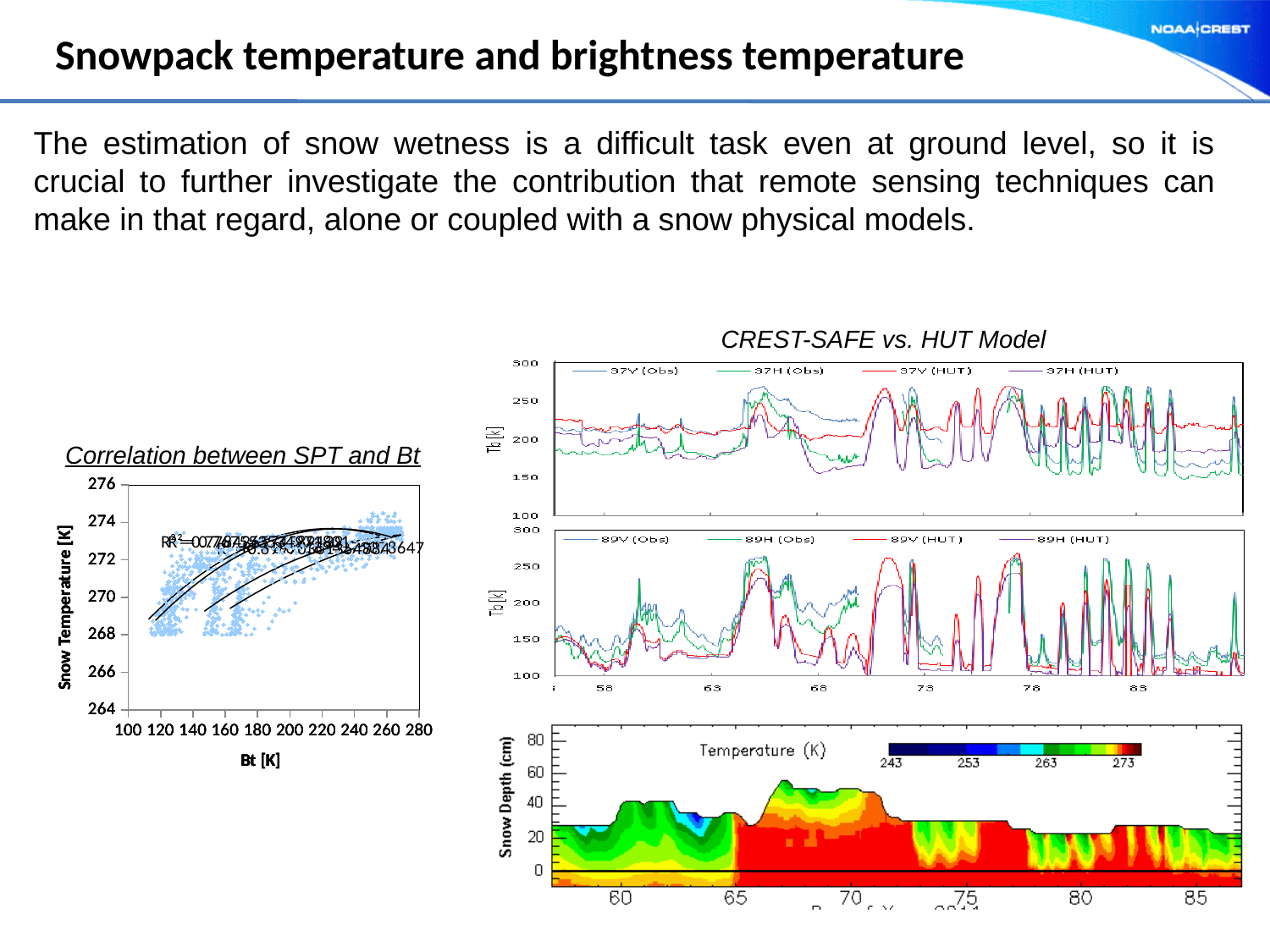
What kind of chart is the 'Correlation between SPT and Bt' chart? scatter plot How many series does the legend of the top panel of 'CREST-SAFE vs. HUT Model' list? 4 In the 'Correlation between SPT and Bt' chart, what is the label of the y axis? Snow Temperature [K] In the top panel of 'CREST-SAFE vs. HUT Model', is the peak of 37V (HUT) near x = 70 greater or less than 200? greater In the bottom snow depth chart, is the snow depth near x = 67 greater or less than 40 cm? greater What kind of chart is the top panel of 'CREST-SAFE vs. HUT Model'? line chart In the top panel of 'CREST-SAFE vs. HUT Model', is the value of 37V (Obs) at the start of the series greater or less than 150? greater How many series does the legend of the second panel of 'CREST-SAFE vs. HUT Model' list? 4 In the 'Correlation between SPT and Bt' chart, what is the label of the x axis? Bt [K]